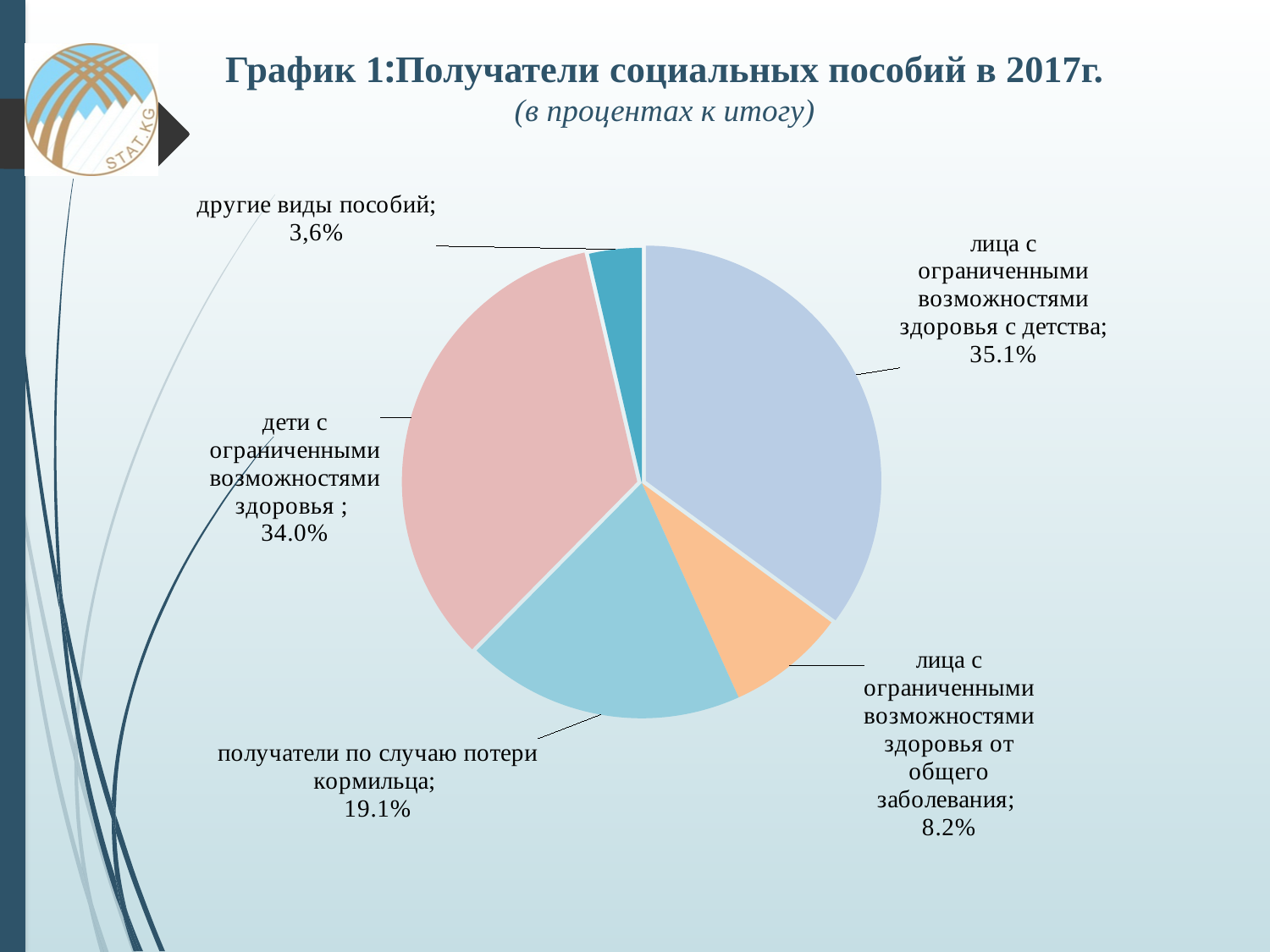
Which is larger: the share for "получатели по случаю потери кормильца" or for "лица с ограниченными возможностями здоровья от общего заболевания"? получатели по случаю потери кормильца How many slices does the pie chart have? 5 What is the share for "дети с ограниченными возможностями здоровья"? 34.0% What type of chart is shown on the slide? pie chart What is the share for "другие виды пособий"? 3,6% Which category has the smallest share of the pie? другие виды пособий What is the title of the chart? График 1:Получатели социальных пособий в 2017г. (в процентах к итогу) Which category has the largest share of the pie? лица с ограниченными возможностями здоровья с детства What is the difference in percentage points between "лица с ограниченными возможностями здоровья с детства" and "дети с ограниченными возможностями здоровья"? 1.1 What is the share for "лица с ограниченными возможностями здоровья с детства"? 35.1% What is the share for "получатели по случаю потери кормильца"? 19.1% What is the share for "лица с ограниченными возможностями здоровья от общего заболевания"? 8.2%